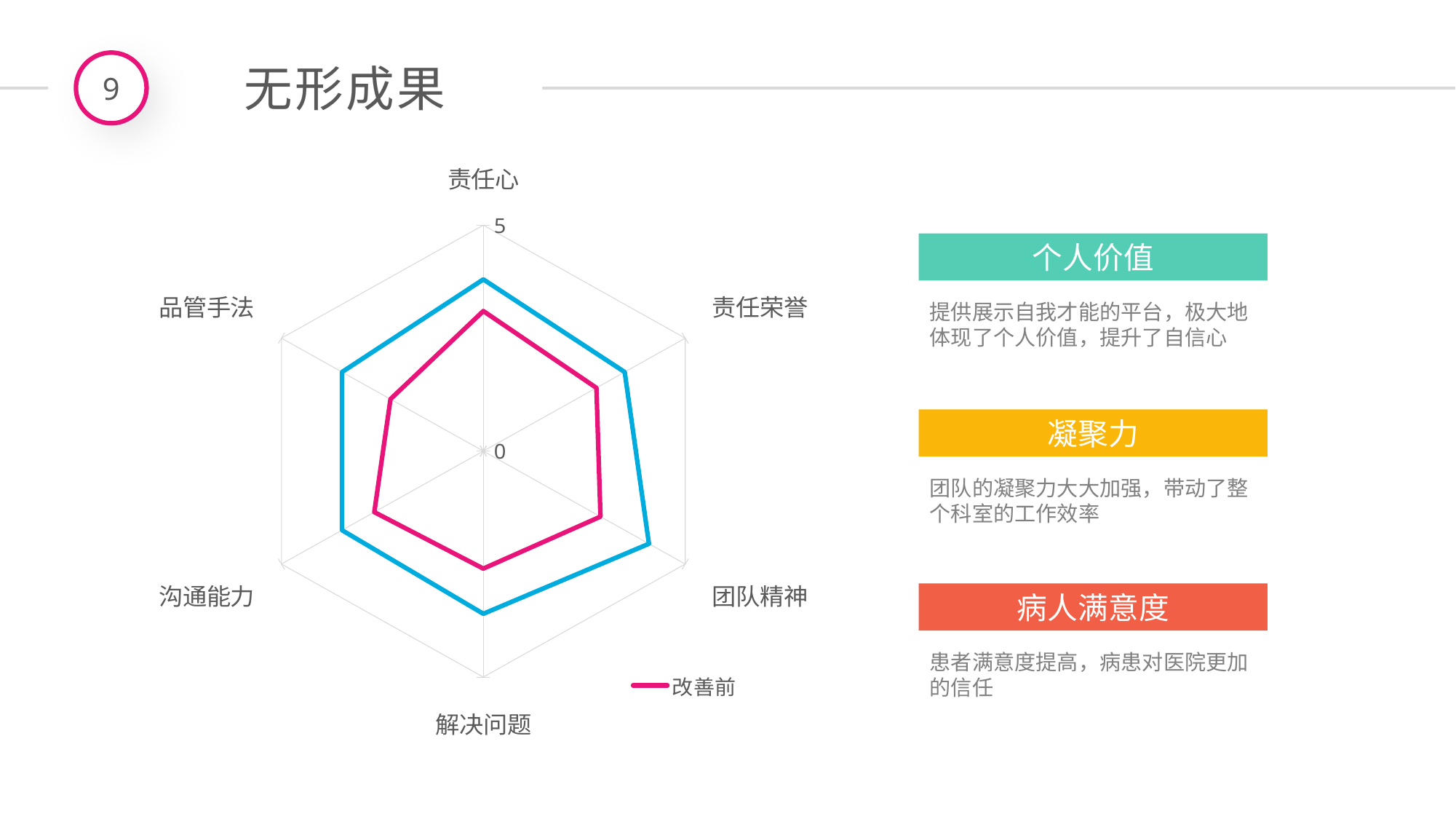
Is the blue line's value for 团队精神 greater or less than 0? greater Is the 改善前 value for 责任心 greater or less than 5? less Which category label appears at the top of the radar chart? 责任心 How many categories (axes) does the radar chart have? 6 How many series does the chart legend list? 1 For 品管手法, which line has the larger value, the blue line or the pink 改善前 line? the blue line For 责任心, which line has the larger value, the blue line or the pink 改善前 line? the blue line What is the maximum value shown on the radar chart's axis scale? 5 What is the series name shown in the chart legend? 改善前 For 团队精神, which line has the larger value, the blue line or the pink 改善前 line? the blue line What kind of chart is shown on the slide? radar chart